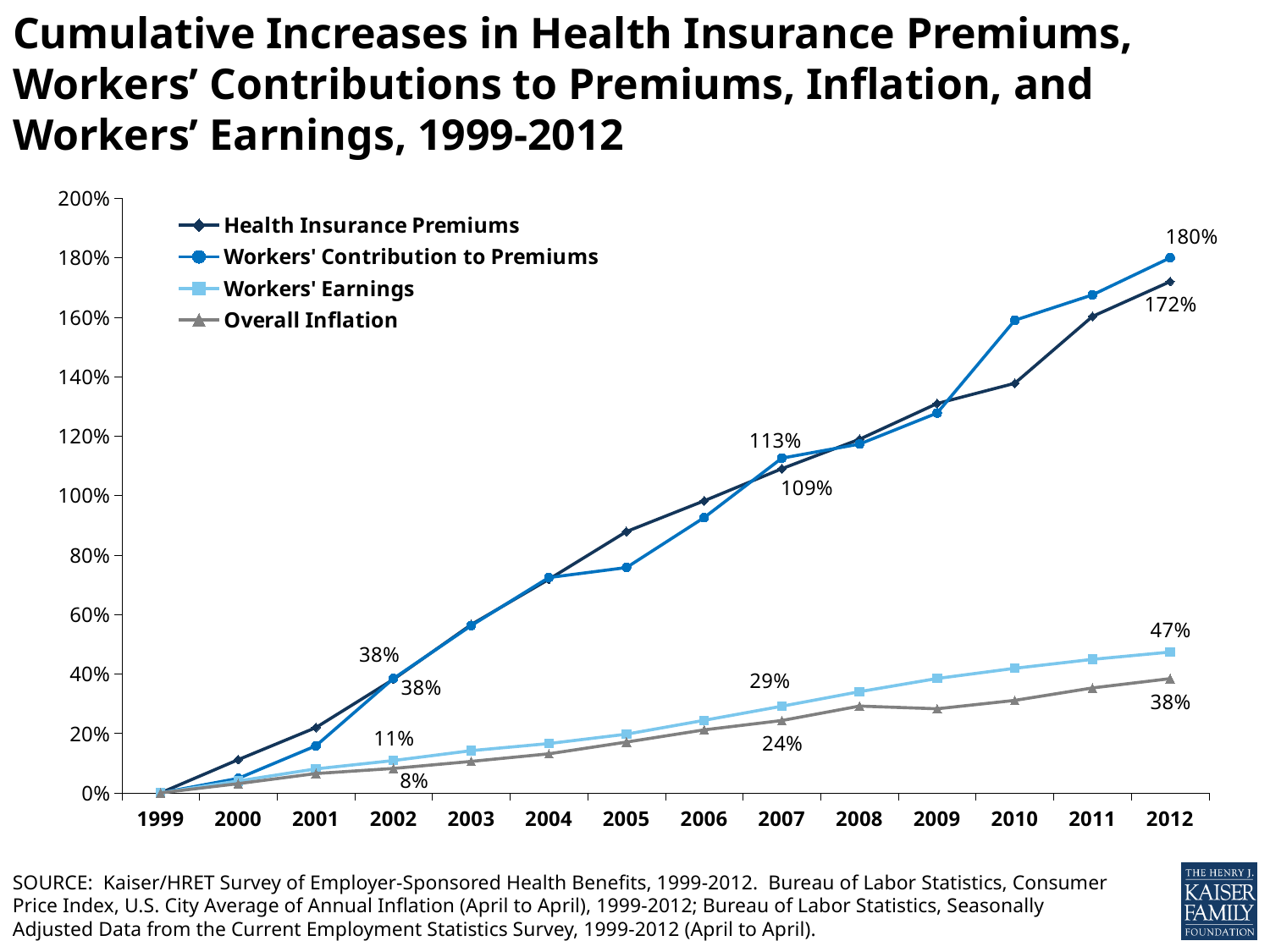
What is the value for Workers' Earnings in 2012? 47% Which series has the highest value in 2012? Workers' Contribution to Premiums In 2007, which is larger: Workers' Contribution to Premiums or Health Insurance Premiums? Workers' Contribution to Premiums How many series does the legend list? 4 In 2012, what is the difference between Workers' Earnings and Overall Inflation? 9% Is the value for Health Insurance Premiums in 2010 greater or less than 120%? greater What kind of chart is shown on the slide? line chart What is the cumulative increase in Workers' Contribution to Premiums in 2012? 180% In 2012, how much higher is Workers' Contribution to Premiums than Health Insurance Premiums? 8% What is the value for Workers' Earnings in 2002? 11% What is the value for Overall Inflation in 2007? 24% What is the cumulative increase in Health Insurance Premiums in 2012? 172%